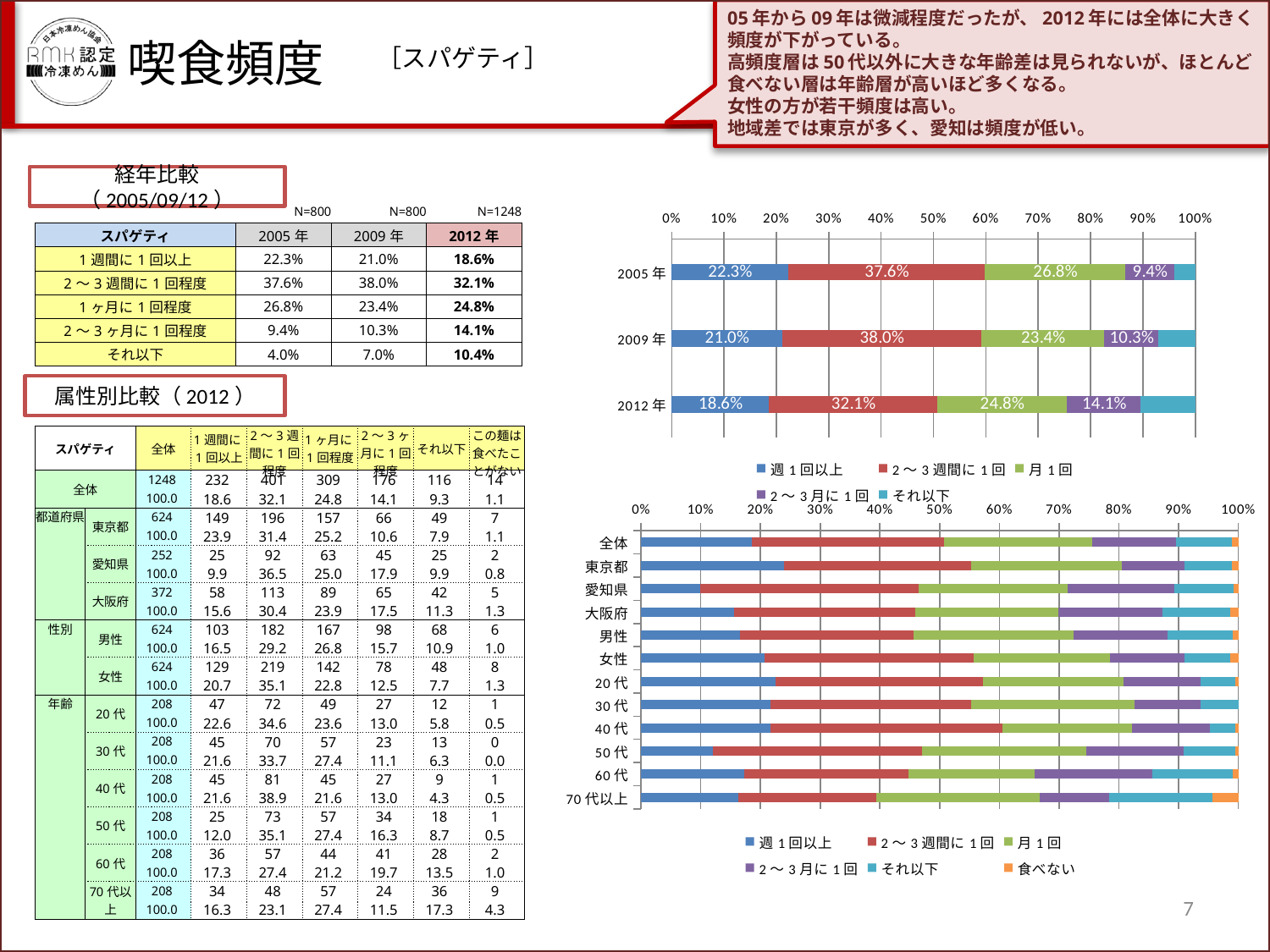
In the top chart (経年比較), what is the value of 2～3週間に1回 for 2009年? 38.0% In the top chart (経年比較), does the 週1回以上 value rise or fall from 2005年 to 2012年? fall In the top chart (経年比較), what is the difference between the 2～3週間に1回 values for 2009年 and 2012年? 5.9% What kind of chart is the bottom chart (属性別比較)? stacked bar chart How many series does the legend of the top chart (経年比較) list? 5 In the top chart (経年比較), what is the value of 2～3月に1回 for 2012年? 14.1% In the top chart (経年比較), what is the value of 月1回 for 2005年? 26.8% In the top chart (経年比較), which is larger: 月1回 for 2009年 or 月1回 for 2012年? 2012年 In the bottom chart (属性別比較), is the 週1回以上 value for 東京都 greater or less than 20%? greater In the top chart (経年比較), which year has the highest value for 週1回以上? 2005年 In the top chart (経年比較), what is the value of 週1回以上 for 2012年? 18.6% How many categories are shown on the bottom chart (属性別比較)? 12